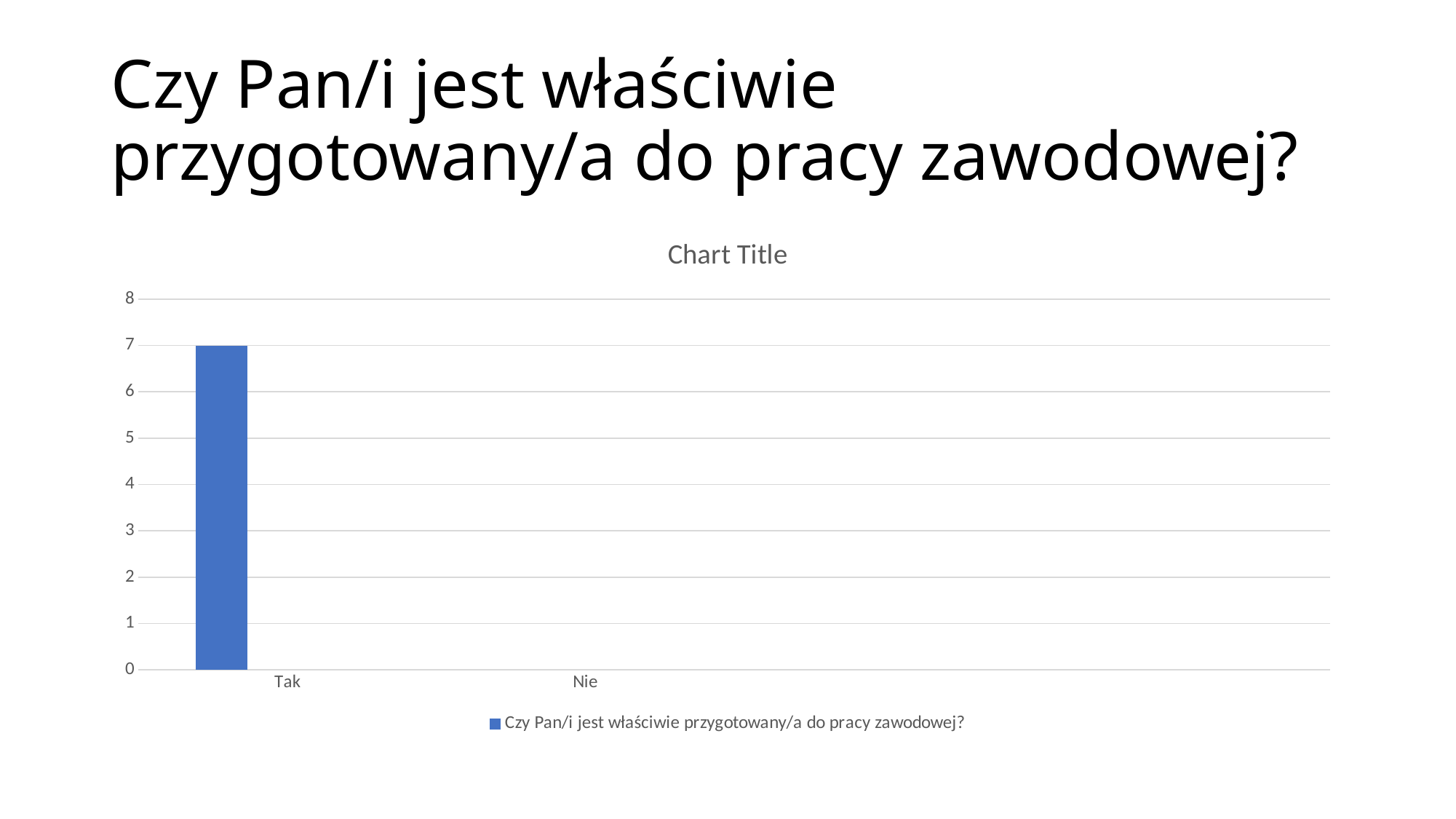
Which is larger, the value for Tak or the value for Nie? Tak What is the legend entry for the series? Czy Pan/i jest właściwie przygotowany/a do pracy zawodowej? Which category has the lowest value? Nie Is the value for Tak greater or less than 5? greater What type of chart is shown on the slide? bar chart What is the value for Tak? 7 How many categories are shown on the x axis? 2 How many series does the legend list? 1 Which category has the highest value? Tak What is the title shown above the chart? Chart Title